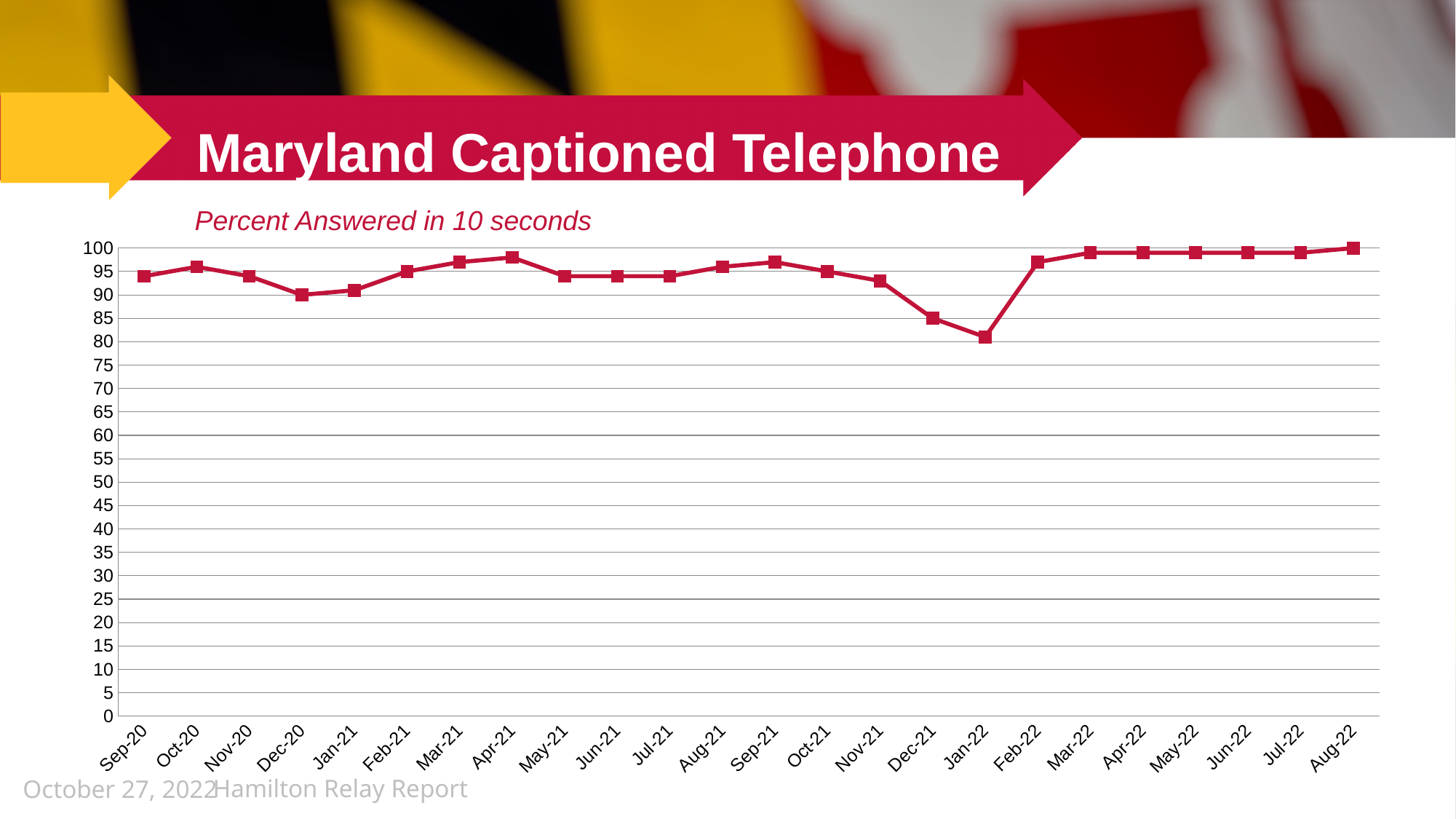
What is the percent answered in 10 seconds for Dec-20? 90 What kind of chart is shown on the slide? line chart Is the value for Jan-22 greater or less than 85? less Which month has the lowest percent answered in 10 seconds? Jan-22 Is the value for Nov-21 greater or less than 95? less What is the subtitle of the chart? Percent Answered in 10 seconds Do the values rise or fall from Nov-21 to Jan-22? fall Which month has the higher value, Dec-20 or Apr-21? Apr-21 Which month has the higher value, Jan-22 or Feb-22? Feb-22 What is the percent answered in 10 seconds for Dec-21? 85 Is the value for Apr-21 greater or less than 95? greater How many monthly data points are plotted on the chart? 24